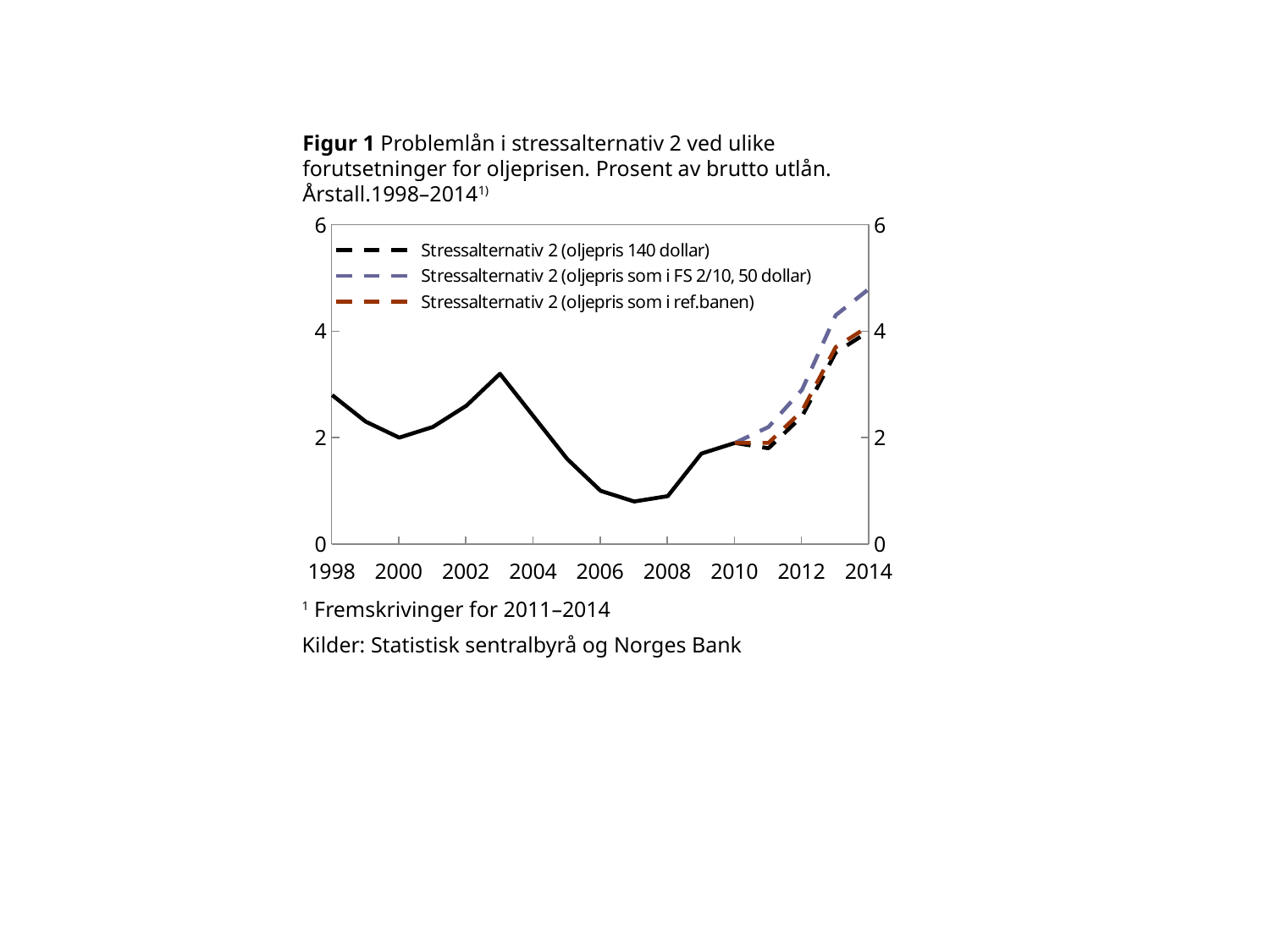
How many series does the legend list? 3 Is the 2014 value for 'Stressalternativ 2 (oljepris som i FS 2/10, 50 dollar)' greater or less than 4? greater Is the value in 2007 greater or less than 2? less In 2014, which series is higher: 'Stressalternativ 2 (oljepris 140 dollar)' or 'Stressalternativ 2 (oljepris som i FS 2/10, 50 dollar)'? Stressalternativ 2 (oljepris som i FS 2/10, 50 dollar) Do the projected values rise or fall from 2011 to 2014? rise Which is higher, the value in 2003 or the value in 1998? 2003 Between 1998 and 2010, in which year does the line reach its highest value? 2003 What kind of chart is shown on the slide? line chart Between 1998 and 2010, in which year does the line reach its lowest value? 2007 Is the value in 2003 greater or less than 2? greater Do the values rise or fall from 2003 to 2007? fall